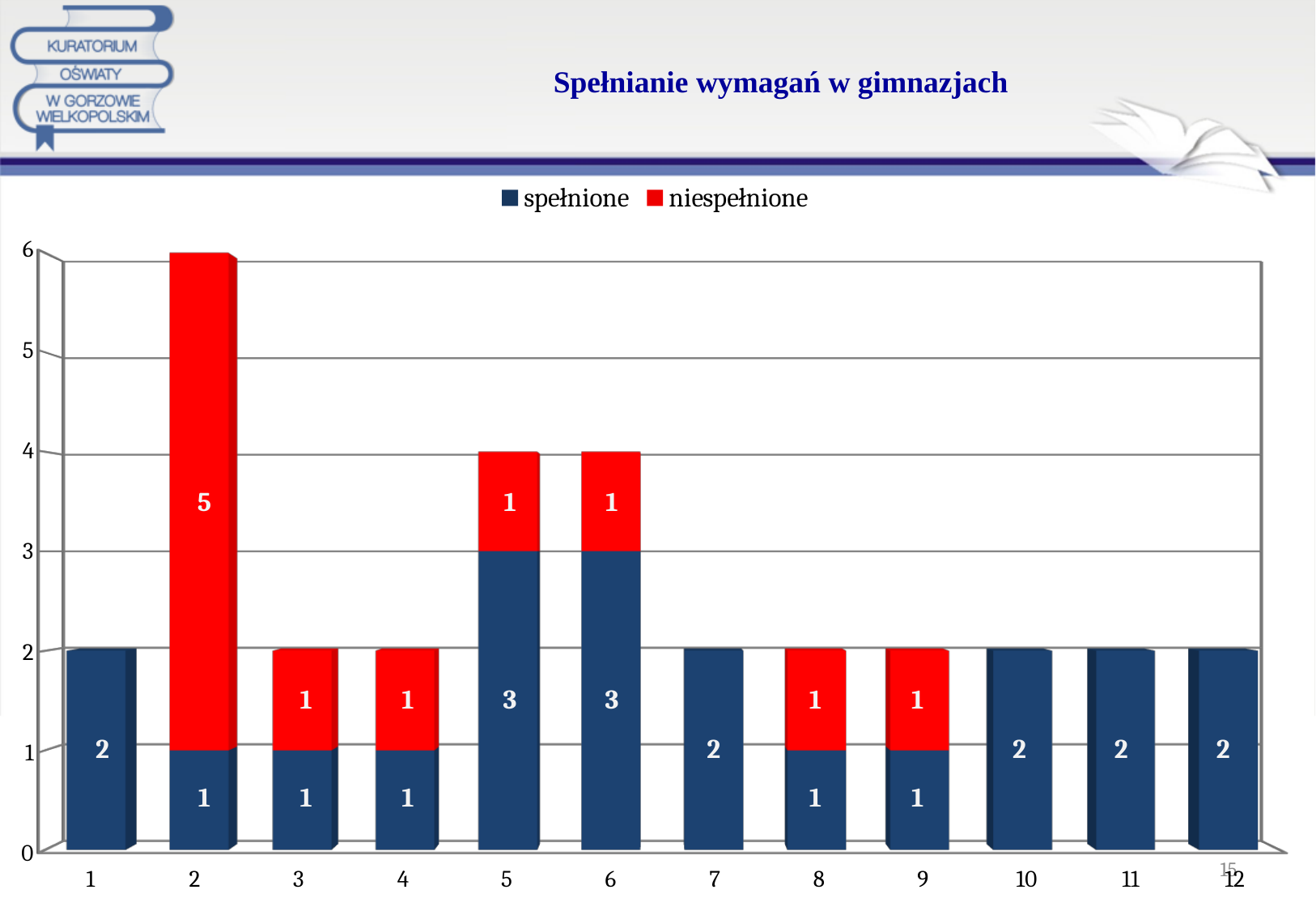
What is the total of the stacked bar for category 2? 6 What is the niespełnione value for category 8? 1 What kind of chart is shown on the slide? stacked bar chart What is the difference between the niespełnione value for category 2 and the niespełnione value for category 3? 4 What is the niespełnione value for category 2? 5 What is the spełnione value for category 2? 1 How many series does the legend list? 2 What is the total of the stacked bar for category 6? 4 Which is larger, the spełnione value for category 5 or the spełnione value for category 9? category 5 How many categories are shown on the x axis? 12 What is the spełnione value for category 5? 3 Which category has the highest niespełnione value? 2